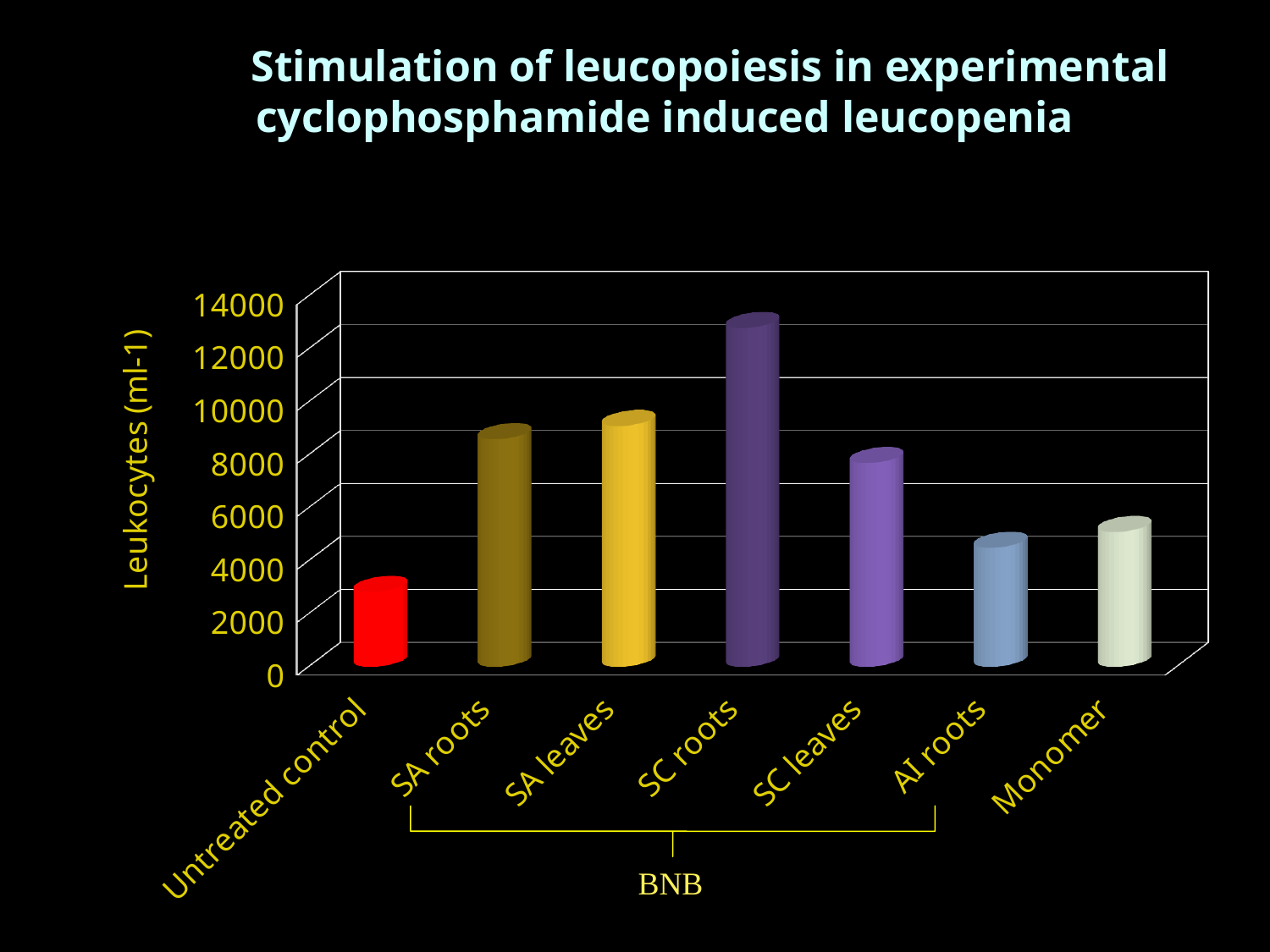
What is the label on the vertical axis? Leukocytes (ml-1) Which is larger, the value for SC roots or the value for SA leaves? SC roots Which category has the highest leukocyte count? SC roots How many categories are plotted on the x axis? 7 Is the value for SC roots greater or less than 12000? greater Which is larger, the value for AI roots or the value for SA roots? SA roots Is the value for Untreated control greater or less than 4000? less Is the value for AI roots greater or less than 6000? less What kind of chart is shown on the slide? bar chart Which category has the lowest leukocyte count? Untreated control